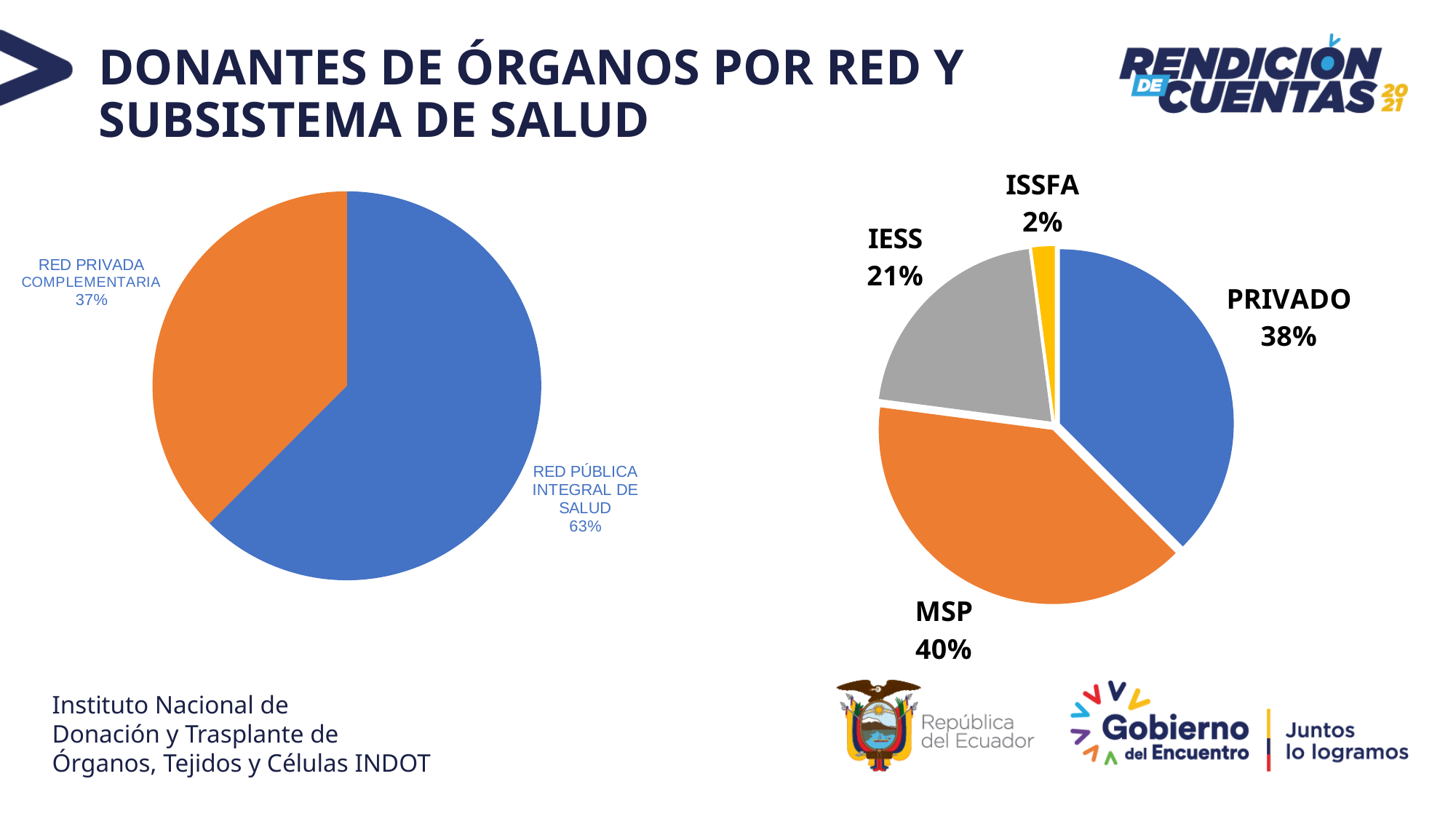
What type of chart is used on the right side of the slide? Pie chart In the right pie chart, which slice is the smallest? ISSFA In the right pie chart, what share is labelled for ISSFA? 2% In the left pie chart, what share is labelled for RED PÚBLICA INTEGRAL DE SALUD? 63% How many slices does the right pie chart have? 4 In the right pie chart, what share is labelled for IESS? 21% In the left pie chart, what share is labelled for RED PRIVADA COMPLEMENTARIA? 37% In the left pie chart, what is the difference in percentage points between RED PÚBLICA INTEGRAL DE SALUD and RED PRIVADA COMPLEMENTARIA? 26 percentage points In the right pie chart, what share is labelled for MSP? 40% How many slices does the left pie chart have? 2 In the right pie chart, which is larger, PRIVADO or IESS? PRIVADO In the left pie chart, which slice is the largest? RED PÚBLICA INTEGRAL DE SALUD